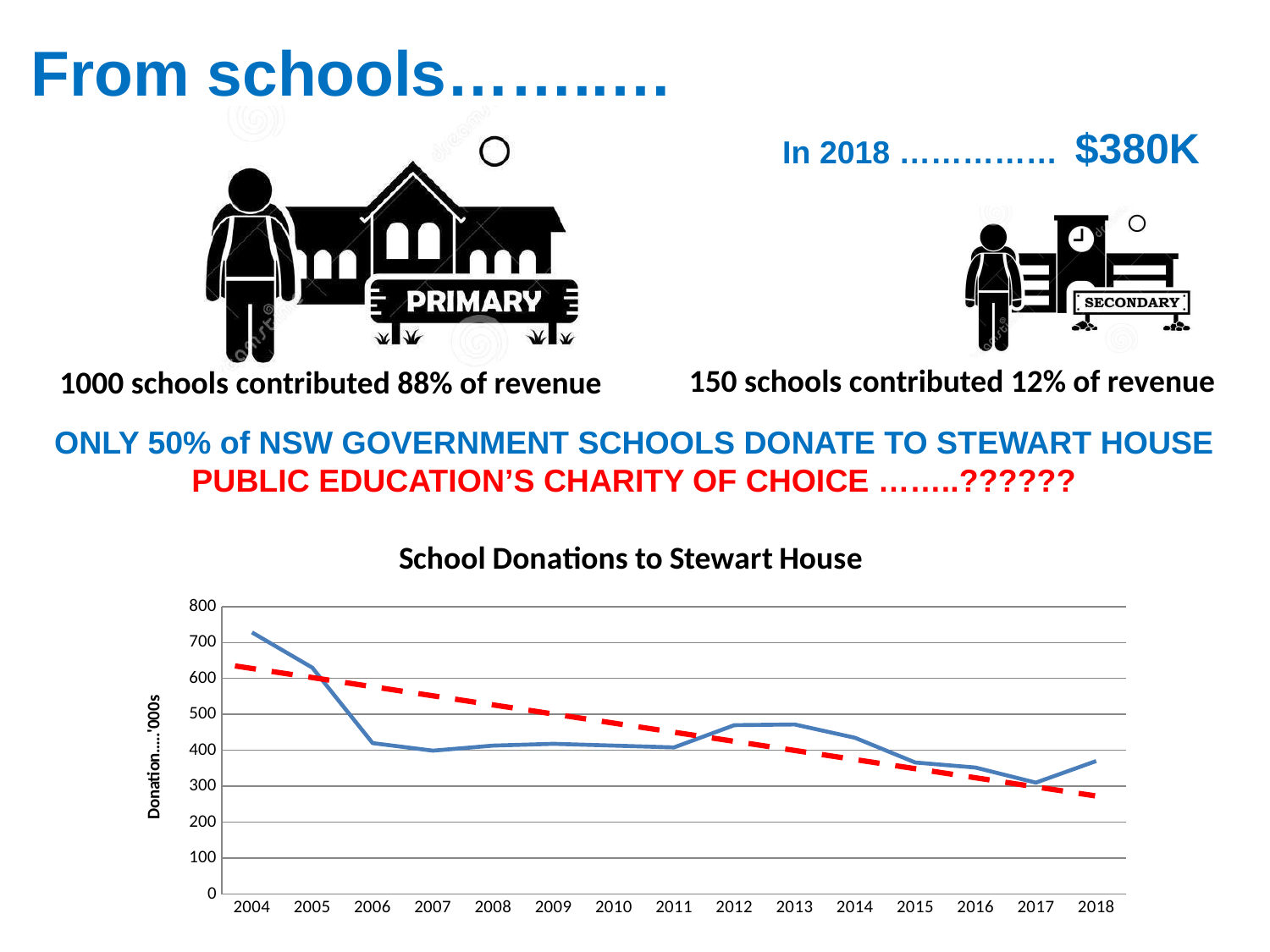
What kind of chart is "School Donations to Stewart House"? line chart In the School Donations to Stewart House chart, is the value for 2017 greater or less than 400? less In the School Donations to Stewart House chart, which year has the larger donation value, 2005 or 2006? 2005 In the School Donations to Stewart House chart, which year has the larger donation value, 2013 or 2016? 2013 In the School Donations to Stewart House chart, is the value for 2012 greater or less than 400? greater Overall, do the school donations rise or fall from 2004 to 2018 in the School Donations to Stewart House chart? fall What is the label on the vertical axis of the School Donations to Stewart House chart? Donation.....'000s What is the title of the chart at the bottom of the slide? School Donations to Stewart House In the School Donations to Stewart House chart, which year has the highest donation value? 2004 How many years are plotted along the x axis of the School Donations to Stewart House chart? 15 In the School Donations to Stewart House chart, is the value for 2004 greater or less than 700? greater In the School Donations to Stewart House chart, which year has the lowest donation value? 2017